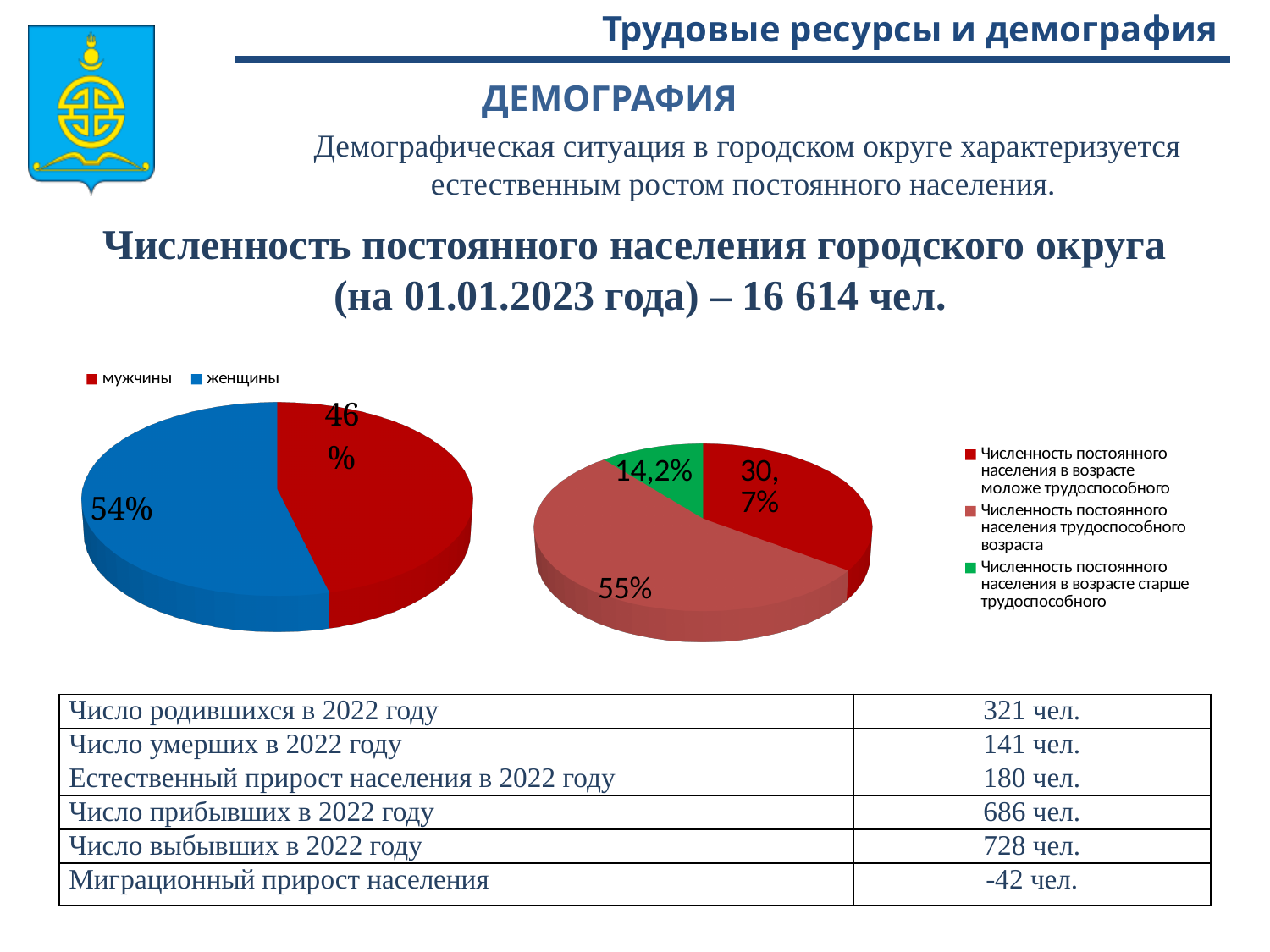
In the right pie chart, which category has the largest share? Численность постоянного населения трудоспособного возраста In the right pie chart, what share is shown for Численность постоянного населения трудоспособного возраста? 55% In the left pie chart, what share is shown for женщины? 54% In the left pie chart, which category has the larger share, мужчины or женщины? женщины How many categories does the right pie chart show? 3 In the left pie chart, what is the difference between the shares of женщины and мужчины? 8% In the right pie chart, what share is shown for Численность постоянного населения в возрасте моложе трудоспособного? 30,7% In the right pie chart, which category has the smallest share? Численность постоянного населения в возрасте старше трудоспособного What type of chart is used on the left side of the slide? pie chart In the left pie chart, what share is shown for мужчины? 46% How many series does the legend of the left pie chart list? 2 In the right pie chart, what share is shown for Численность постоянного населения в возрасте старше трудоспособного? 14,2%